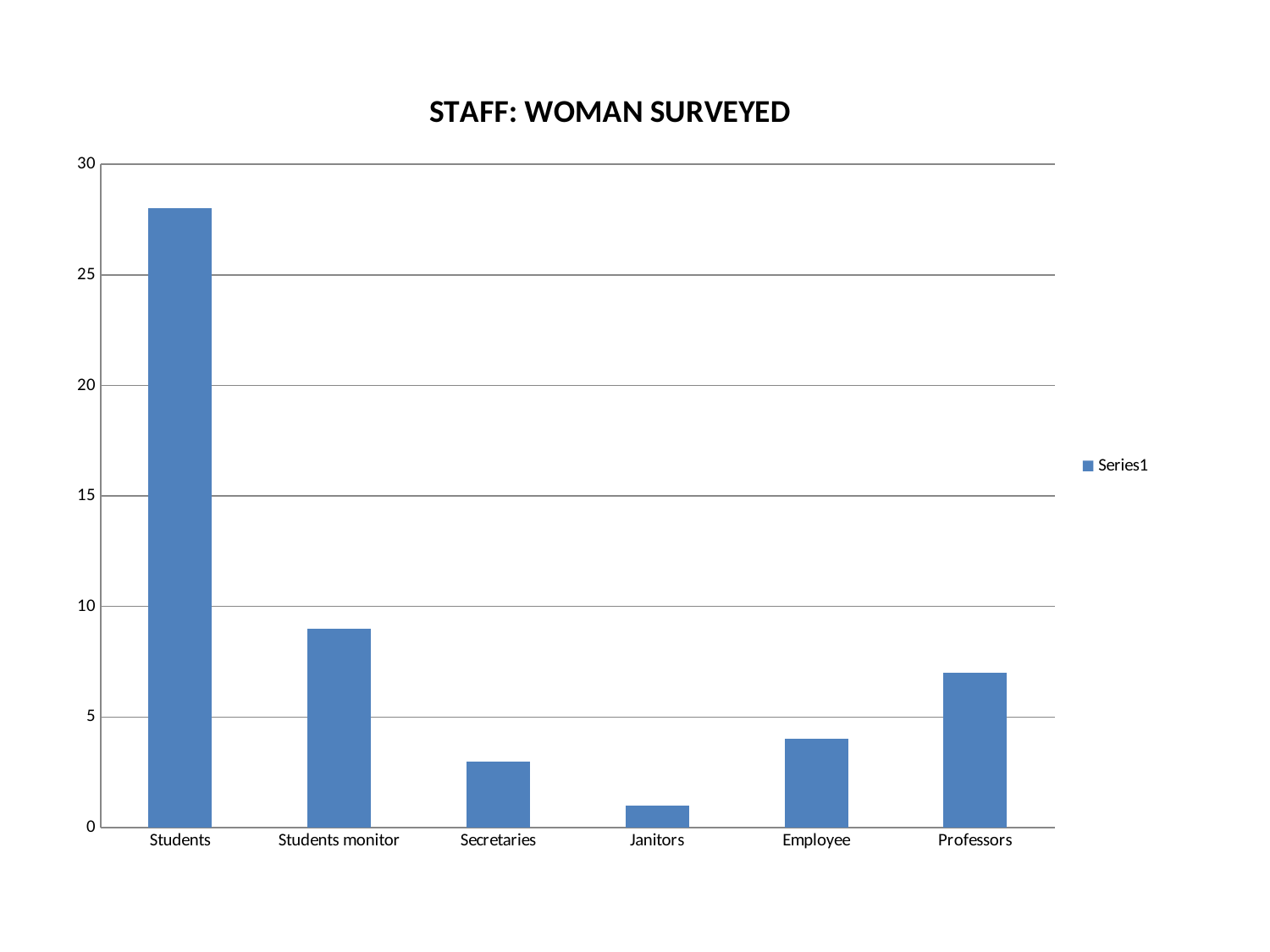
Which is larger, the value for Students monitor or the value for Secretaries? Students monitor Is the value for Secretaries greater or less than 5? less Which category has the highest value? Students Which category has the lowest value? Janitors Is the value for Students greater or less than 25? greater Is the value for Students monitor greater or less than 10? less What kind of chart is shown on the slide? bar chart How many categories are shown on the x axis? 6 What is the title of the chart? STAFF: WOMAN SURVEYED Which is larger, the value for Employee or the value for Professors? Professors How many series does the legend list? 1